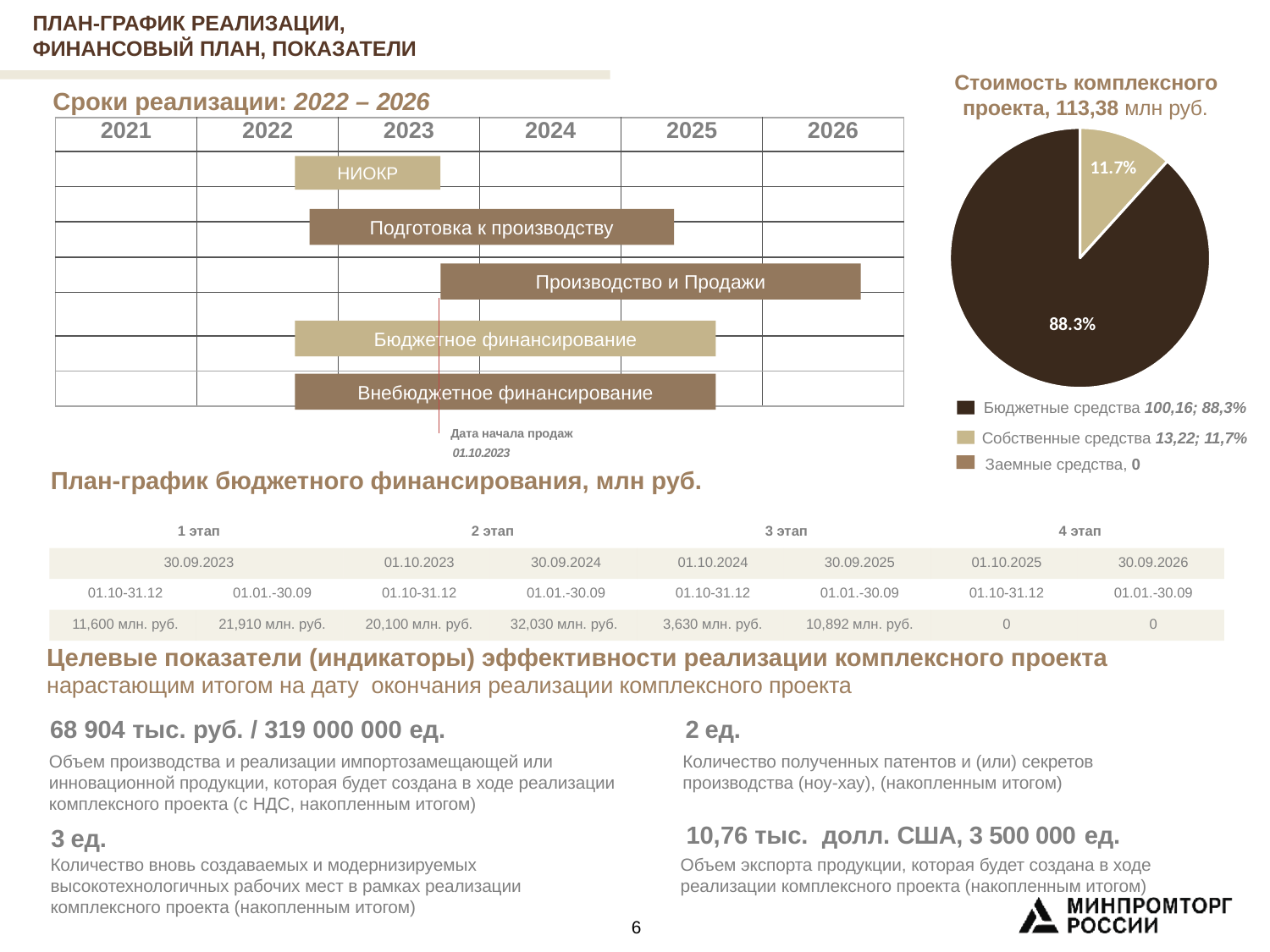
Which category has the smallest value in the pie chart legend? Заемные средства Which category has the largest slice in the pie chart? Бюджетные средства In the pie chart, what share of the project cost is Собственные средства? 11.7% In the pie chart, which is larger: Бюджетные средства or Собственные средства? Бюджетные средства How many categories does the pie chart legend list? 3 According to the pie chart legend, what is the value for Заемные средства? 0 According to the pie chart legend, what is the value for Бюджетные средства? 100,16 In the pie chart, what is the difference between the values for Бюджетные средства and Собственные средства? 86,94 In the pie chart, what share of the project cost is Бюджетные средства? 88.3% According to the pie chart legend, what is the value for Собственные средства? 13,22 What total project cost is stated in the pie chart title? 113,38 млн руб. What kind of chart is used to show the cost of the complex project (Стоимость комплексного проекта)? pie chart